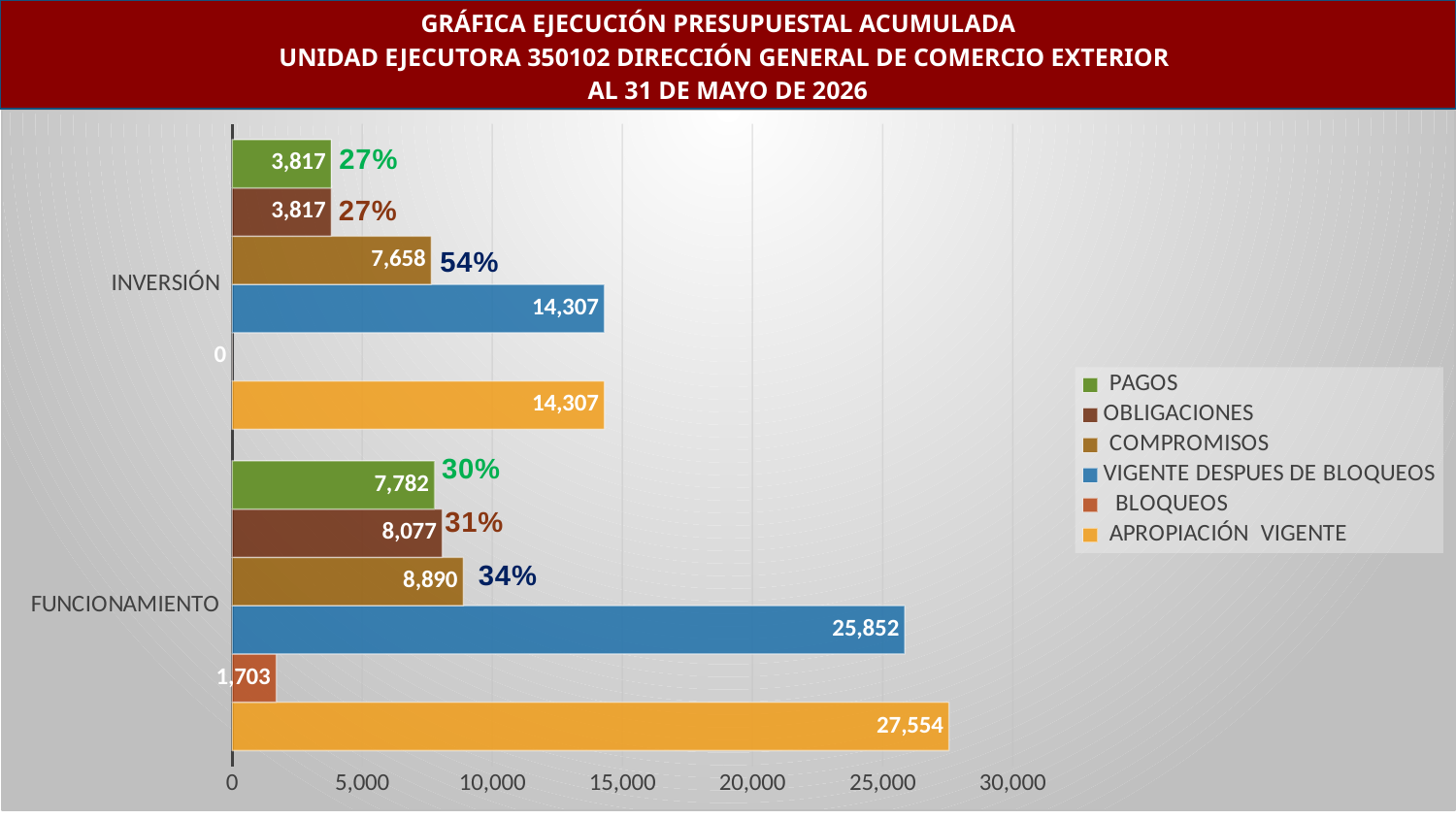
What kind of chart is shown on the slide? Bar chart What is the value of COMPROMISOS for FUNCIONAMIENTO? 8,890 What is the value of PAGOS for INVERSIÓN? 3,817 What percentage is shown next to the COMPROMISOS bar for INVERSIÓN? 54% What is the value of VIGENTE DESPUES DE BLOQUEOS for INVERSIÓN? 14,307 How many series does the legend list? 6 What is the difference between APROPIACIÓN VIGENTE and VIGENTE DESPUES DE BLOQUEOS for FUNCIONAMIENTO? 1,702 What is the value of BLOQUEOS for FUNCIONAMIENTO? 1,703 Which is larger for FUNCIONAMIENTO: OBLIGACIONES or PAGOS? OBLIGACIONES Which series has the highest value for FUNCIONAMIENTO? APROPIACIÓN VIGENTE Which series has the lowest value for INVERSIÓN? BLOQUEOS What is the value of APROPIACIÓN VIGENTE for FUNCIONAMIENTO? 27,554